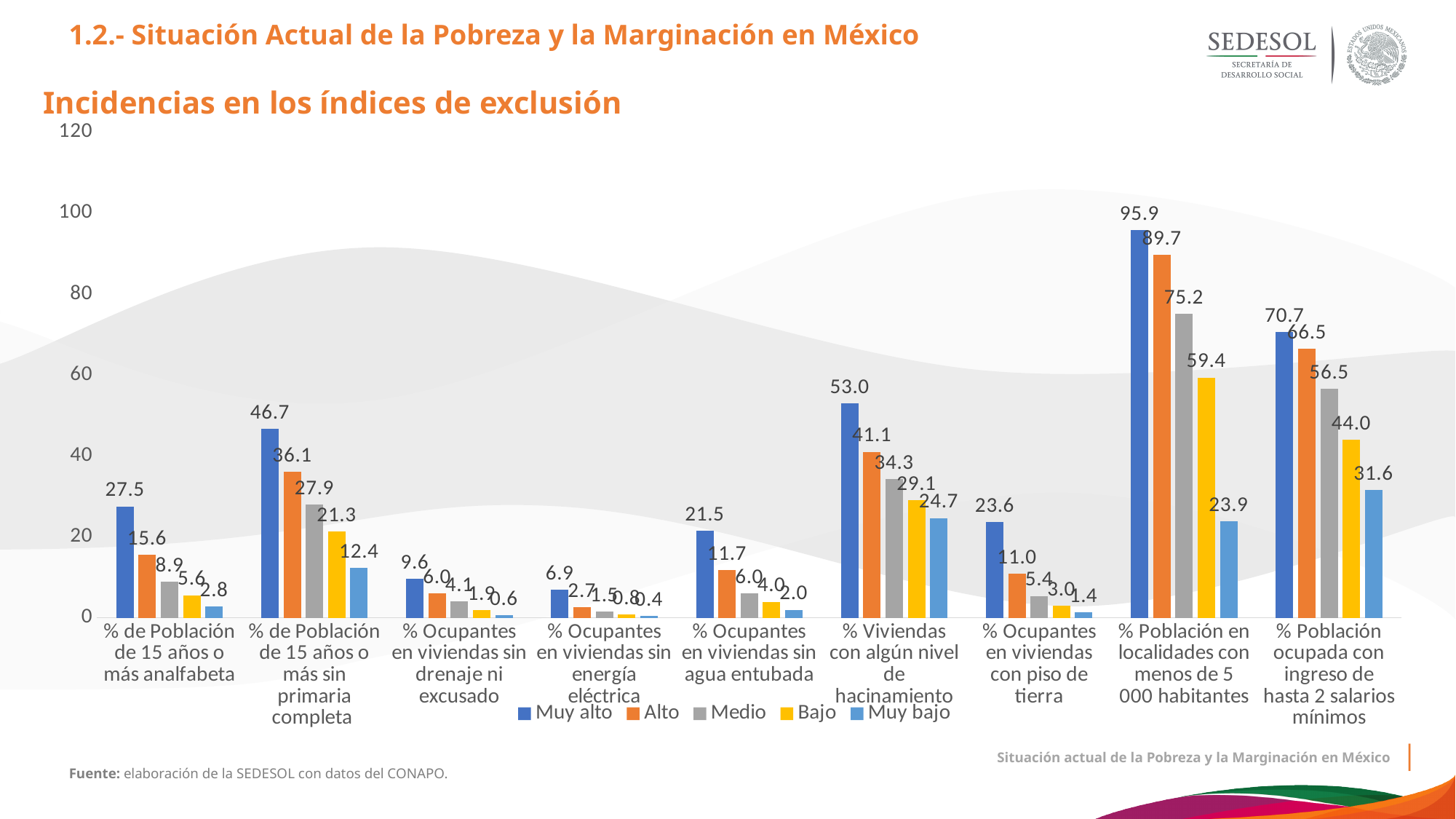
What is the value of the Muy alto series for '% Población en localidades con menos de 5 000 habitantes'? 95.9 What is the value of the Bajo series for '% Población ocupada con ingreso de hasta 2 salarios mínimos'? 44.0 What is the difference between the Muy alto and Alto values for '% de Población de 15 años o más analfabeta'? 11.9 Which is larger for '% Ocupantes en viviendas con piso de tierra': the Alto value or the Medio value? Alto Which category has the lowest Muy alto value? % Ocupantes en viviendas sin energía eléctrica What is the value of the Muy bajo series for '% de Población de 15 años o más sin primaria completa'? 12.4 Which category has the highest Muy alto value? % Población en localidades con menos de 5 000 habitantes How many categories are shown on the x axis? 9 How many series does the legend list? 5 Is the Alto value for '% Población ocupada con ingreso de hasta 2 salarios mínimos' greater or less than 60? greater What is the value of the Medio series for '% Viviendas con algún nivel de hacinamiento'? 34.3 What kind of chart is shown on the slide? Bar chart